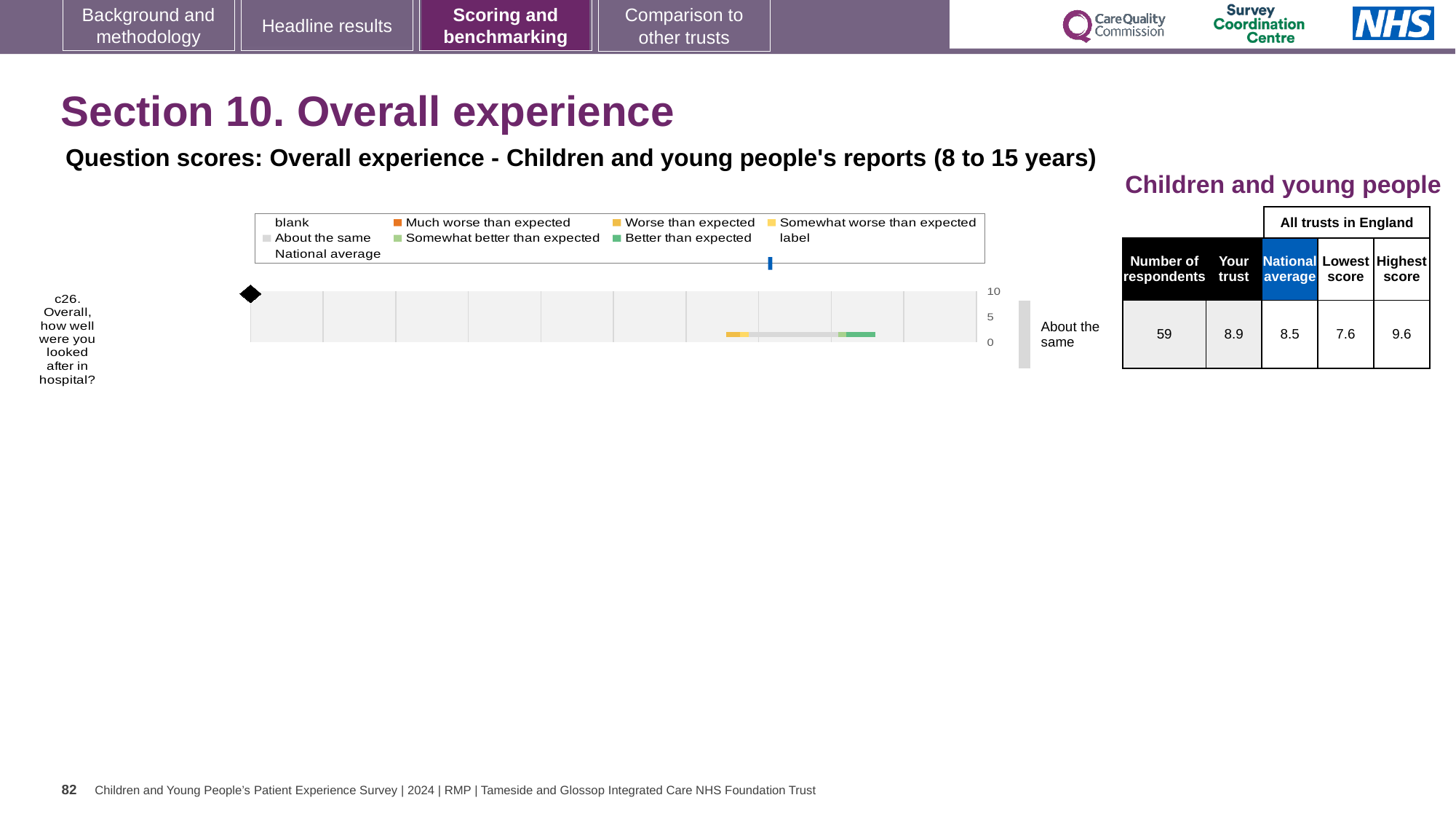
What is the difference between the 'Your trust' score and the national average for c26? 0.4 Is the 'Your trust' score for c26 greater or less than 5 on the chart's axis? greater What colour in the legend represents 'Better than expected'? green What is the lowest score among all trusts in England for c26? 7.6 Which is higher for c26, the 'Your trust' score or the national average? Your trust What kind of chart is shown for question c26? bar chart Which benchmark category is shown for c26 'Overall, how well were you looked after in hospital?'? About the same What is the national average score for c26? 8.5 How many survey questions are plotted on the chart? 1 How many respondents answered c26? 59 What is the 'Your trust' score for c26? 8.9 What is the highest score among all trusts in England for c26? 9.6